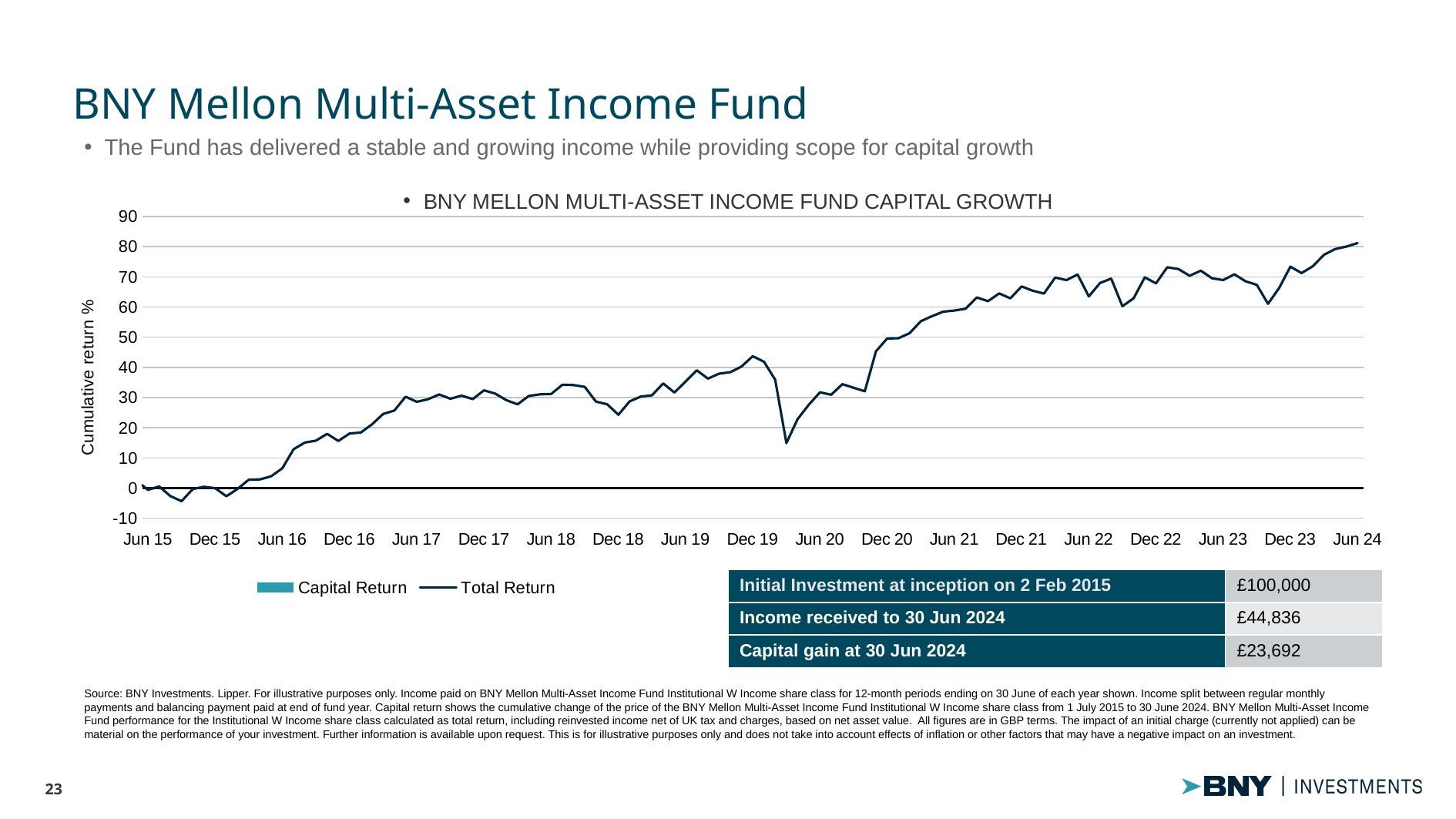
Overall, does the Total Return line rise or fall from Jun 15 to Jun 24? rise Is the Total Return value at Jun 21 greater or less than 50? greater What is the title of the chart? BNY MELLON MULTI-ASSET INCOME FUND CAPITAL GROWTH What is the label on the vertical axis of the chart? Cumulative return % Is the Total Return value at Jun 16 greater or less than 20? less What kind of chart is shown on the slide? line chart Is the Total Return value at Dec 20 greater or less than 40? greater How many date labels are shown along the x axis of the chart? 19 How many series does the chart legend list? 2